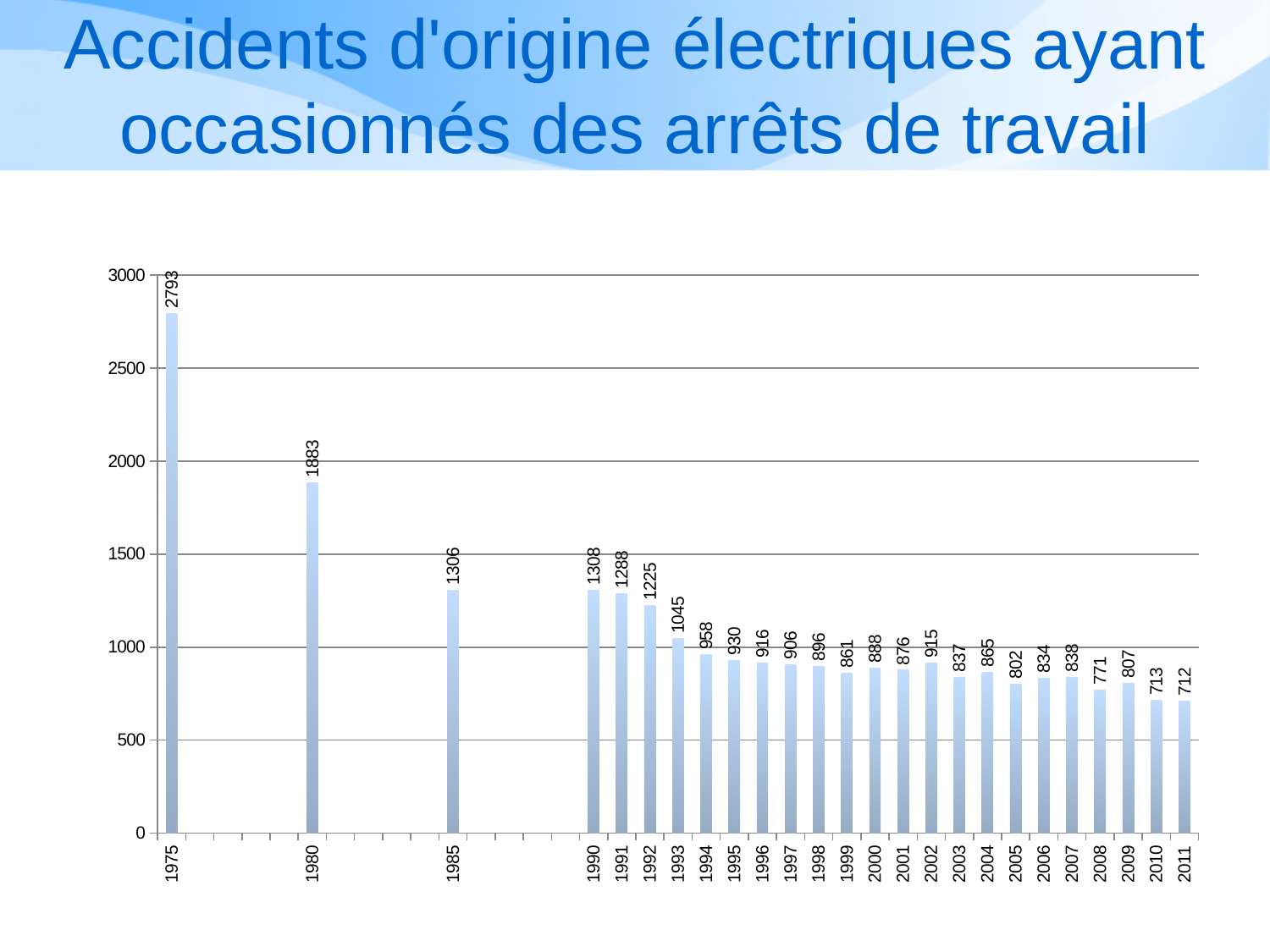
Is the value for 1994 greater or less than 1000? less What kind of chart is shown on the slide? bar chart Do the values generally rise or fall from 1975 to 2011? fall What is the value for 1975? 2793 What is the value for 2011? 712 Which is larger, the value for 1985 or the value for 1990? 1990 What is the value for 2002? 915 What is the difference between the values for 1990 and 2011? 596 How many years are plotted on the chart? 25 What is the difference between the values for 1975 and 1980? 910 Which year has the highest value? 1975 What is the value for 1993? 1045